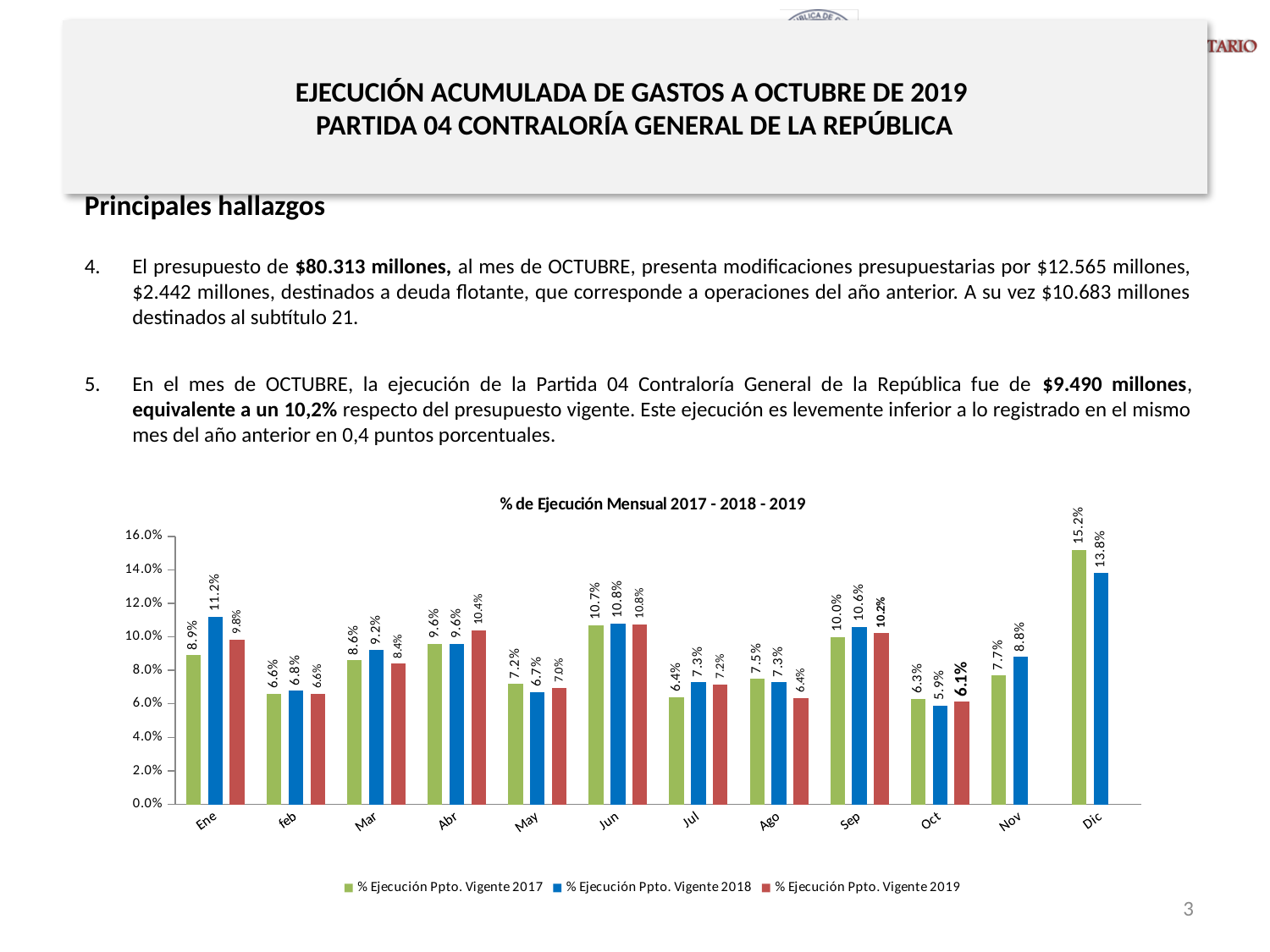
What is the value for % Ejecución Ppto. Vigente 2017 in Dic? 15.2% What is the title of the chart? % de Ejecución Mensual 2017 - 2018 - 2019 What is the value for % Ejecución Ppto. Vigente 2018 in Ene? 11.2% How many month categories are shown on the x axis of the chart? 12 What is the value for % Ejecución Ppto. Vigente 2019 in Oct? 6.1% Which month has the highest value for % Ejecución Ppto. Vigente 2018? Dic Is the value for % Ejecución Ppto. Vigente 2019 in Abr greater or less than 10.0%? greater What type of chart is shown on the slide? bar chart What is the difference between the 2017 and 2018 values in Dic? 1.4% Which is larger in Ago: the 2017 value or the 2019 value? 2017 value How many series does the chart legend list? 3 Which month has the lowest value for % Ejecución Ppto. Vigente 2019? Oct